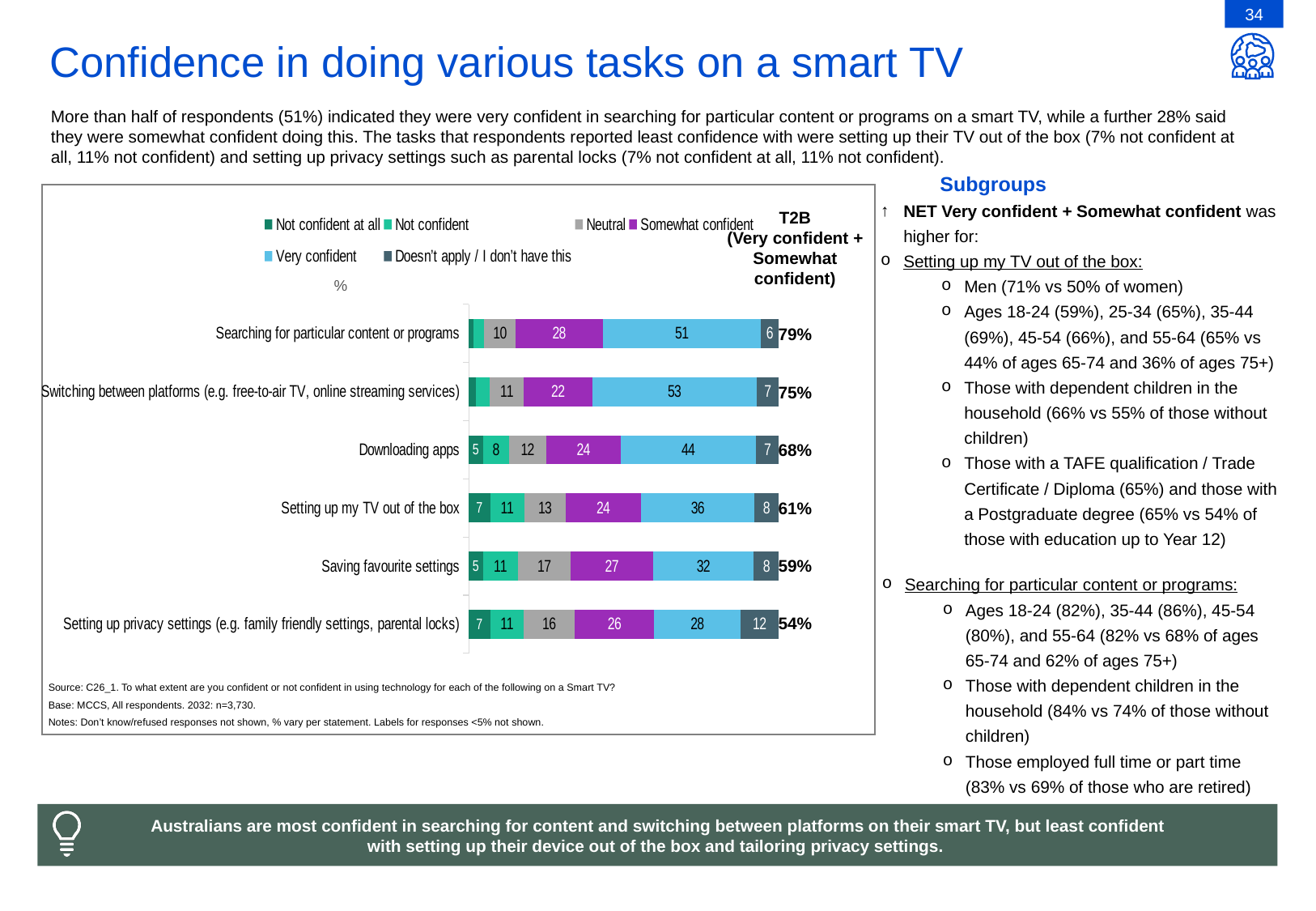
What is the 'Neutral' value for 'Setting up privacy settings (e.g. family friendly settings, parental locks)'? 16 Which task has the highest 'Very confident' value? Switching between platforms (e.g. free-to-air TV, online streaming services) Which task has the lowest 'Very confident' value? Setting up privacy settings (e.g. family friendly settings, parental locks) What kind of chart is shown on the slide? Stacked bar chart Which has the larger 'Somewhat confident' value: 'Downloading apps' or 'Saving favourite settings'? Saving favourite settings What is the 'Doesn't apply / I don't have this' value for 'Setting up privacy settings (e.g. family friendly settings, parental locks)'? 12 What is the T2B (Very confident + Somewhat confident) value for 'Downloading apps'? 68% How many series does the chart legend list? 6 How many tasks are shown in the chart? 6 What is the 'Somewhat confident' value for 'Saving favourite settings'? 27 What is the difference between the 'Very confident' values for 'Searching for particular content or programs' and 'Setting up privacy settings (e.g. family friendly settings, parental locks)'? 23 What is the 'Very confident' value for 'Searching for particular content or programs'? 51